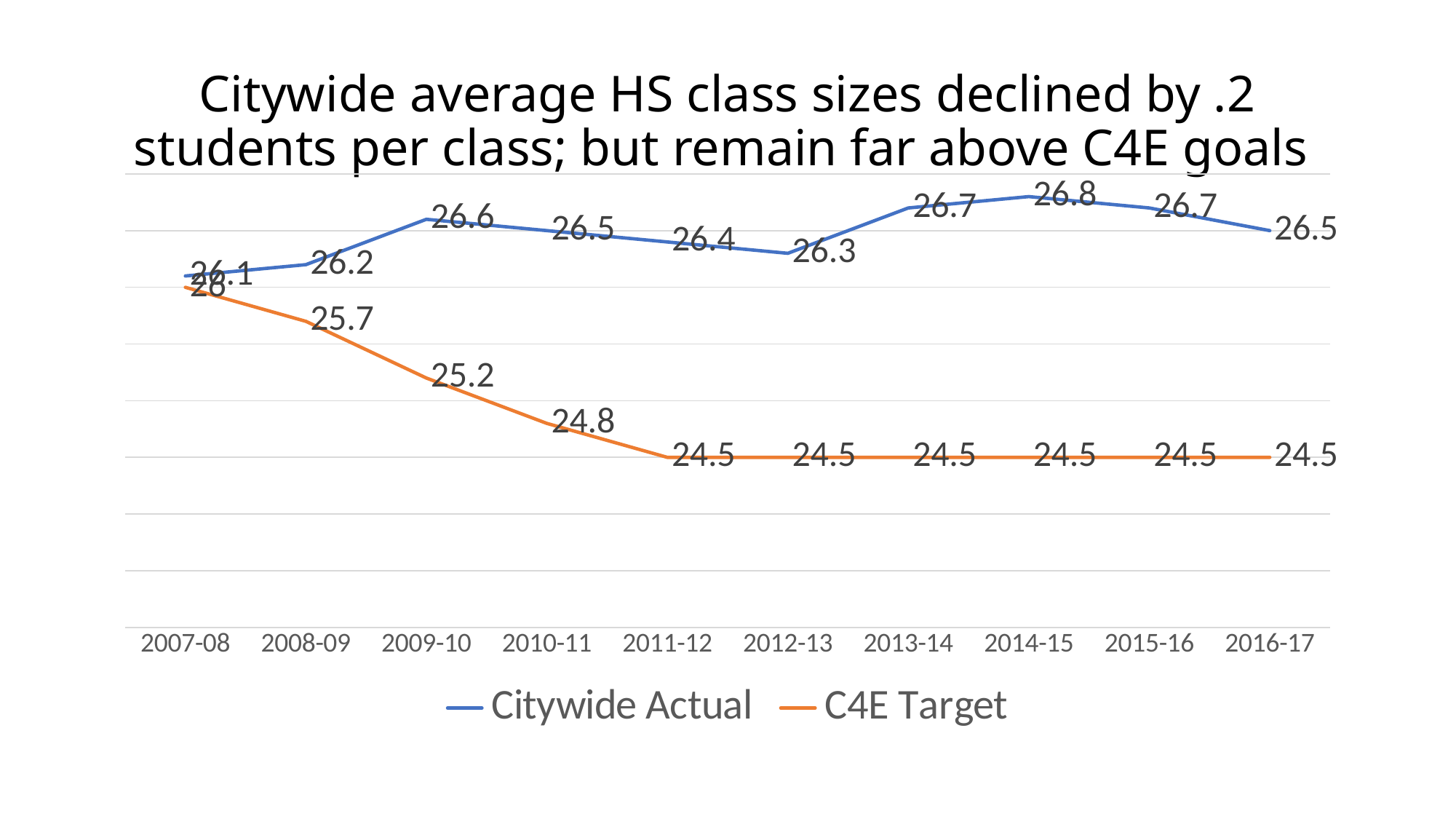
How many series does the legend list? 2 What is the Citywide Actual value for 2016-17? 26.5 What is the Citywide Actual value for 2014-15? 26.8 What is the C4E Target value for 2009-10? 25.2 In which school year is the Citywide Actual value highest? 2014-15 What kind of chart is shown on the slide? line chart Which colour is used for the C4E Target line? orange Does the C4E Target series rise or fall from 2007-08 to 2011-12? fall How many school years are shown on the x axis? 10 In which school year is the Citywide Actual value lowest? 2007-08 Which series has the larger value in 2011-12, Citywide Actual or C4E Target? Citywide Actual What is the difference between the Citywide Actual and C4E Target values in 2016-17? 2